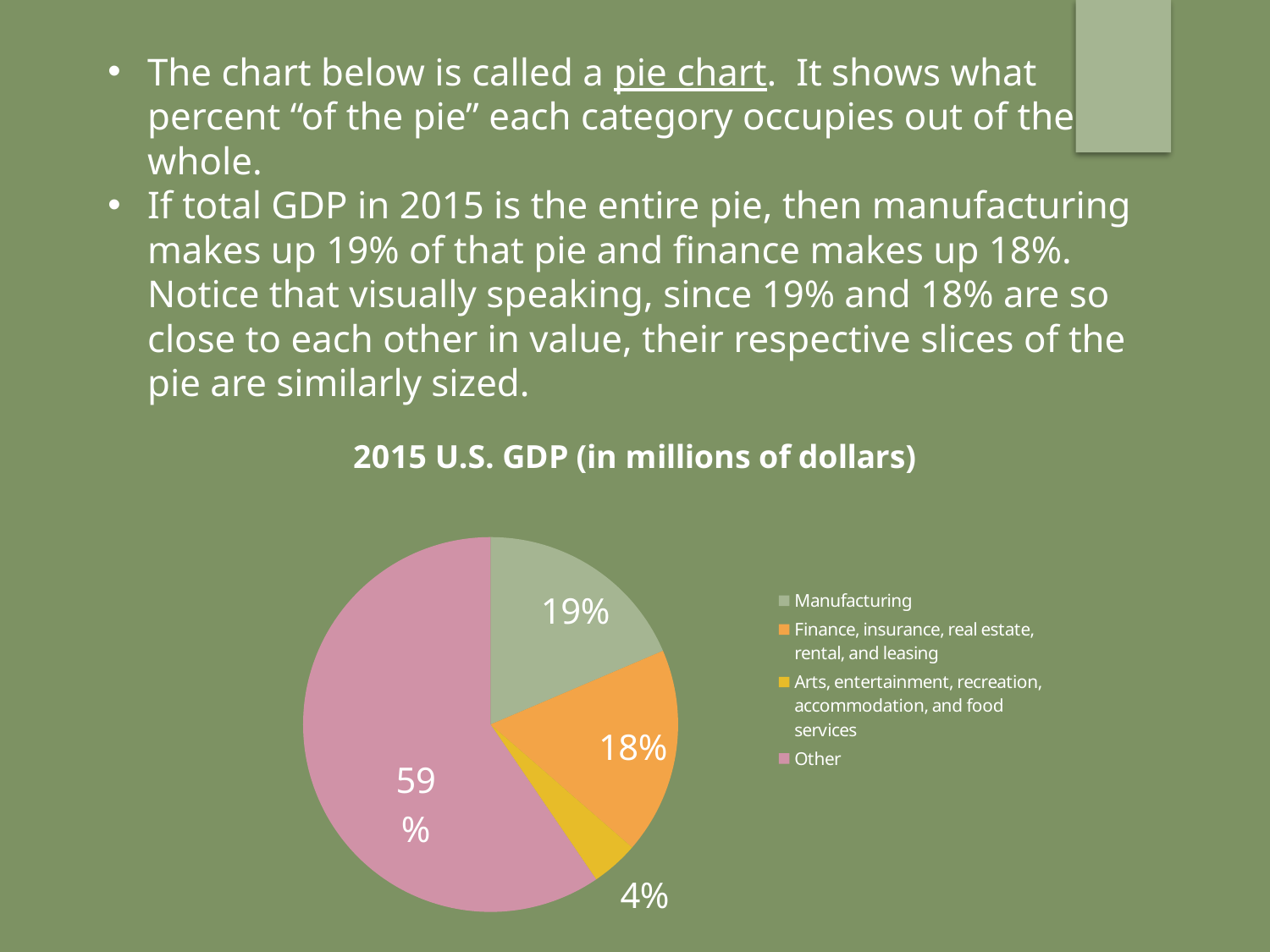
What kind of chart is shown on the slide? pie chart What share of the pie does Finance, insurance, real estate, rental, and leasing occupy? 18% Which category has the largest slice of the pie? Other What share of the pie does Manufacturing occupy? 19% What colour is the Other slice of the pie? pink What is the title of the chart? 2015 U.S. GDP (in millions of dollars) How many categories does the legend list? 4 Which is larger, the Manufacturing slice or the Arts, entertainment, recreation, accommodation, and food services slice? Manufacturing What is the difference in percentage points between the Other slice and the Manufacturing slice? 40 What share of the pie does Arts, entertainment, recreation, accommodation, and food services occupy? 4% What share of the pie does Other occupy? 59% Which category has the smallest slice of the pie? Arts, entertainment, recreation, accommodation, and food services